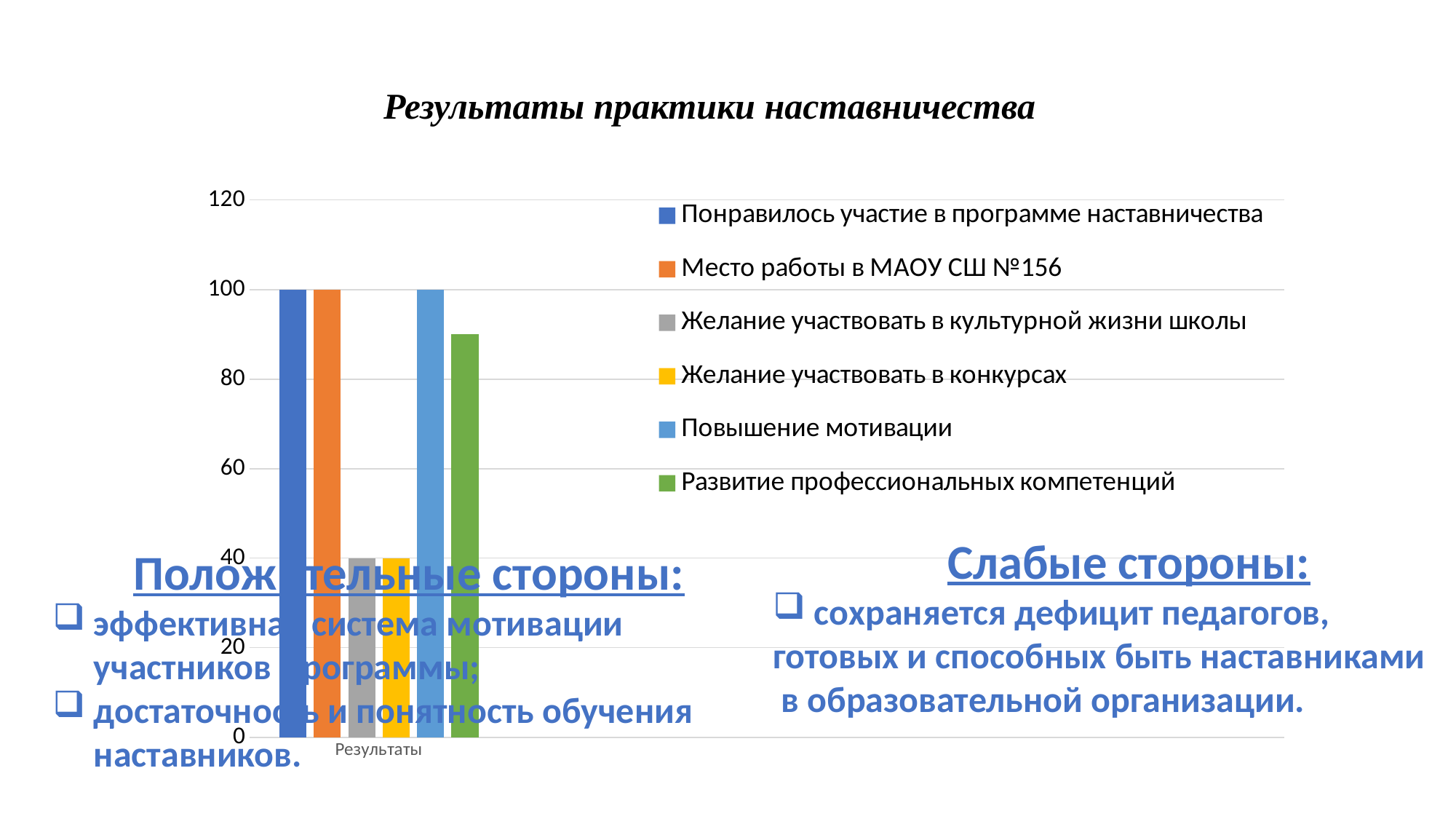
What is the value for "Понравилось участие в программе наставничества"? 100 How many categories are shown on the x axis of the chart? 1 What is the value for "Место работы в МАОУ СШ №156"? 100 What is the label of the single category on the x axis? Результаты Is the value for "Развитие профессиональных компетенций" greater or less than 80? greater What is the title of the chart? Результаты практики наставничества What is the value for "Желание участвовать в конкурсах"? 40 What kind of chart is shown on the slide? Bar chart Is the value for "Развитие профессиональных компетенций" greater or less than 100? less Which is larger: "Повышение мотивации" or "Желание участвовать в культурной жизни школы"? Повышение мотивации What is the difference between the values for "Место работы в МАОУ СШ №156" and "Желание участвовать в культурной жизни школы"? 60 How many series does the chart legend list? 6